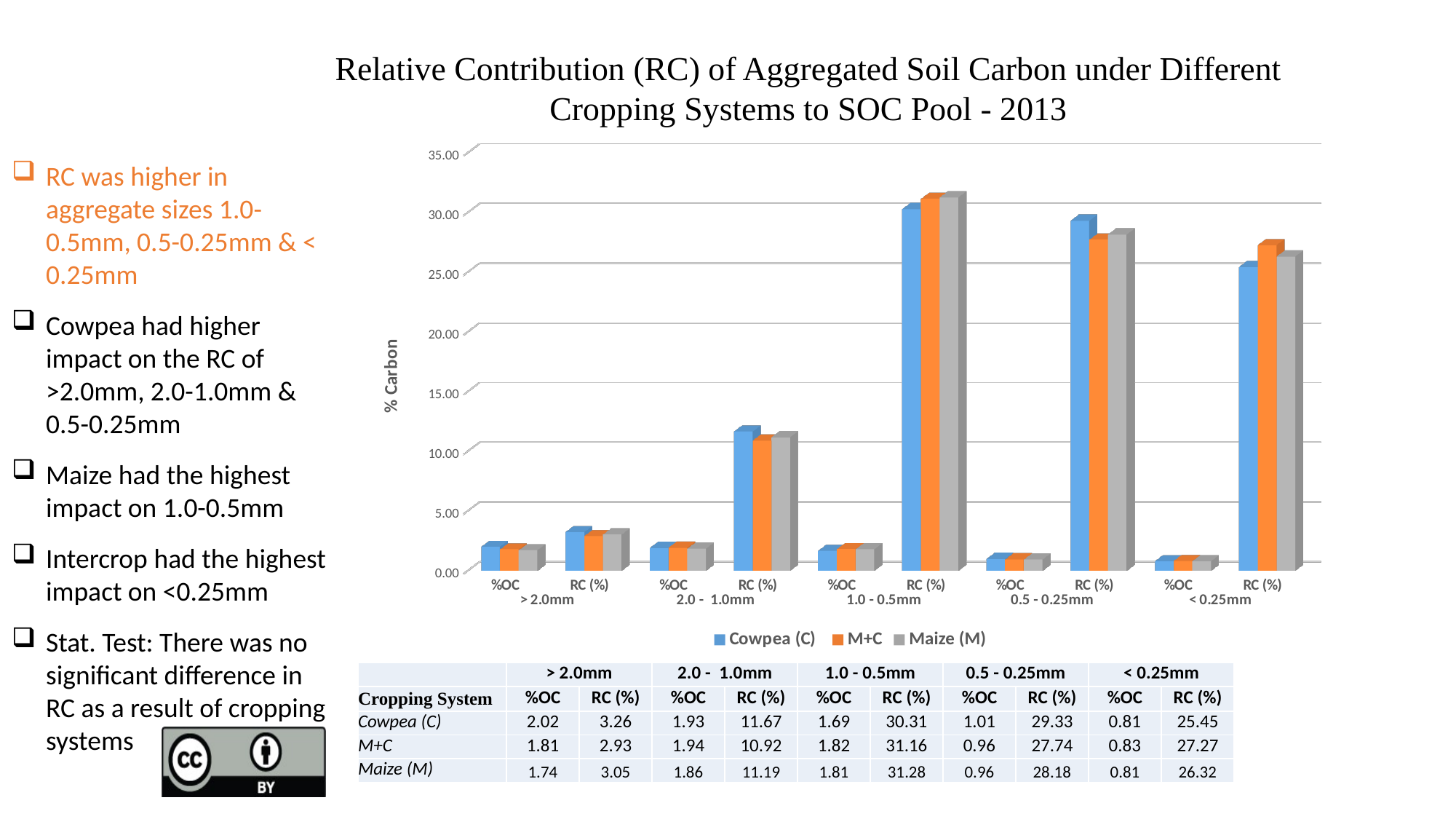
What is the %OC value for Maize (M) in the > 2.0mm aggregate size? 1.74 In the < 0.25mm aggregate size, which has the larger RC (%): Cowpea (C) or M+C? M+C What is the RC (%) value for Cowpea (C) in the 1.0 - 0.5mm aggregate size? 30.31 What kind of chart is shown on the slide? bar chart What is the title of the chart's vertical axis? % Carbon Is the RC (%) value for Maize (M) in the 1.0 - 0.5mm aggregate size greater or less than 30? greater How many aggregate size classes are shown along the x axis of the chart? 5 What is the difference between the RC (%) of Cowpea (C) and M+C in the 0.5 - 0.25mm aggregate size? 1.59 What is the RC (%) value for M+C in the < 0.25mm aggregate size? 27.27 How many series does the chart legend list? 3 Which cropping system has the highest RC (%) in the 0.5 - 0.25mm aggregate size? Cowpea (C) Which cropping system has the lowest RC (%) in the 2.0 - 1.0mm aggregate size? M+C